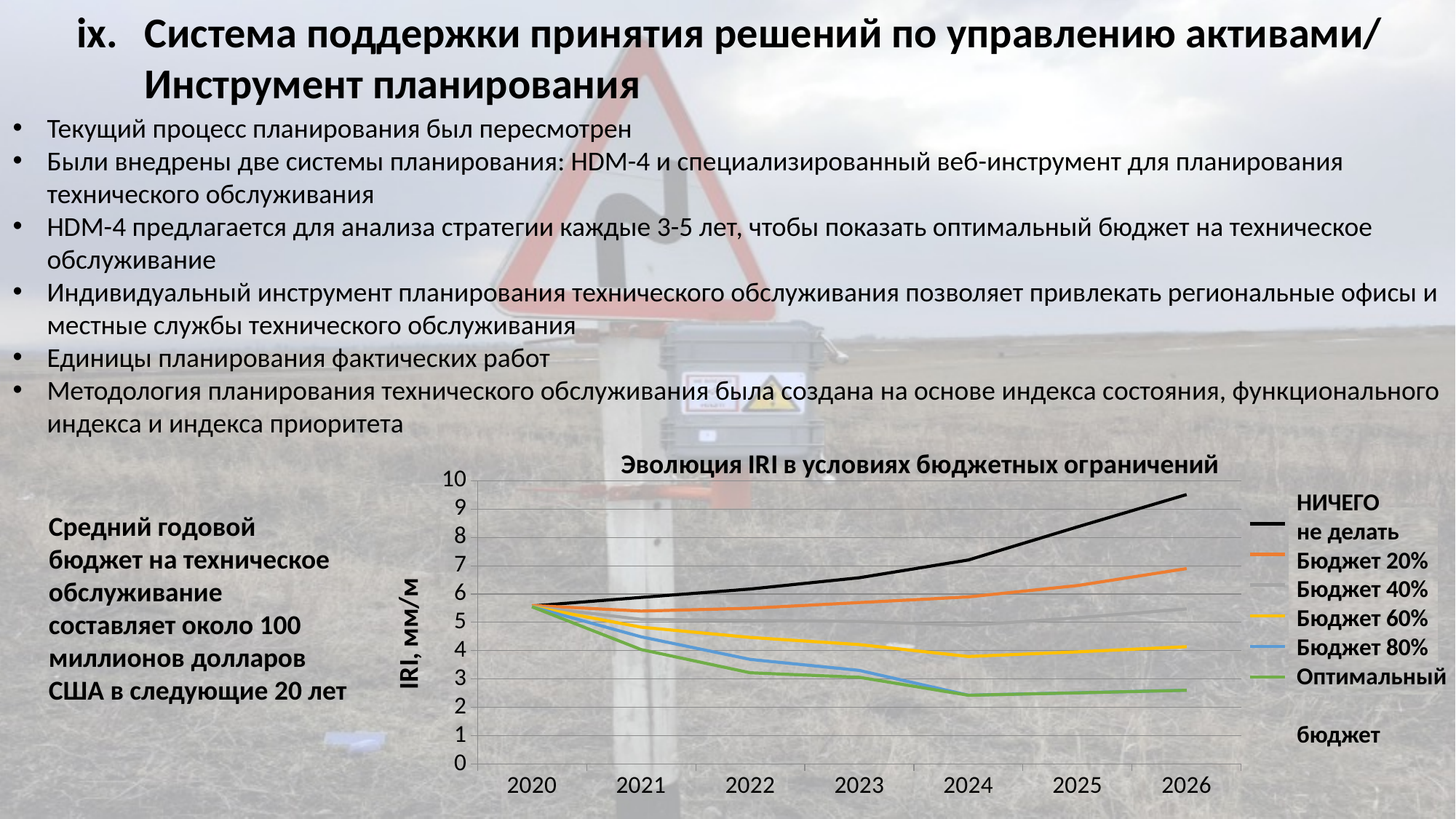
Is the value for НИЧЕГО не делать in 2026 greater or less than 8? greater Is the value for Бюджет 20% in 2026 greater or less than 6? greater How many years are shown on the x axis of the chart? 7 Is the value for Бюджет 60% in 2026 greater or less than 5? less How many series does the chart legend list? 6 What is the title of the chart? Эволюция IRI в условиях бюджетных ограничений Does the НИЧЕГО не делать series rise or fall from 2020 to 2026? rise Which series has the highest value in 2026? НИЧЕГО не делать What is the label of the y axis of the chart? IRI, мм/м In 2026, which is larger: Бюджет 20% or Бюджет 60%? Бюджет 20% What kind of chart is shown on the slide? line chart